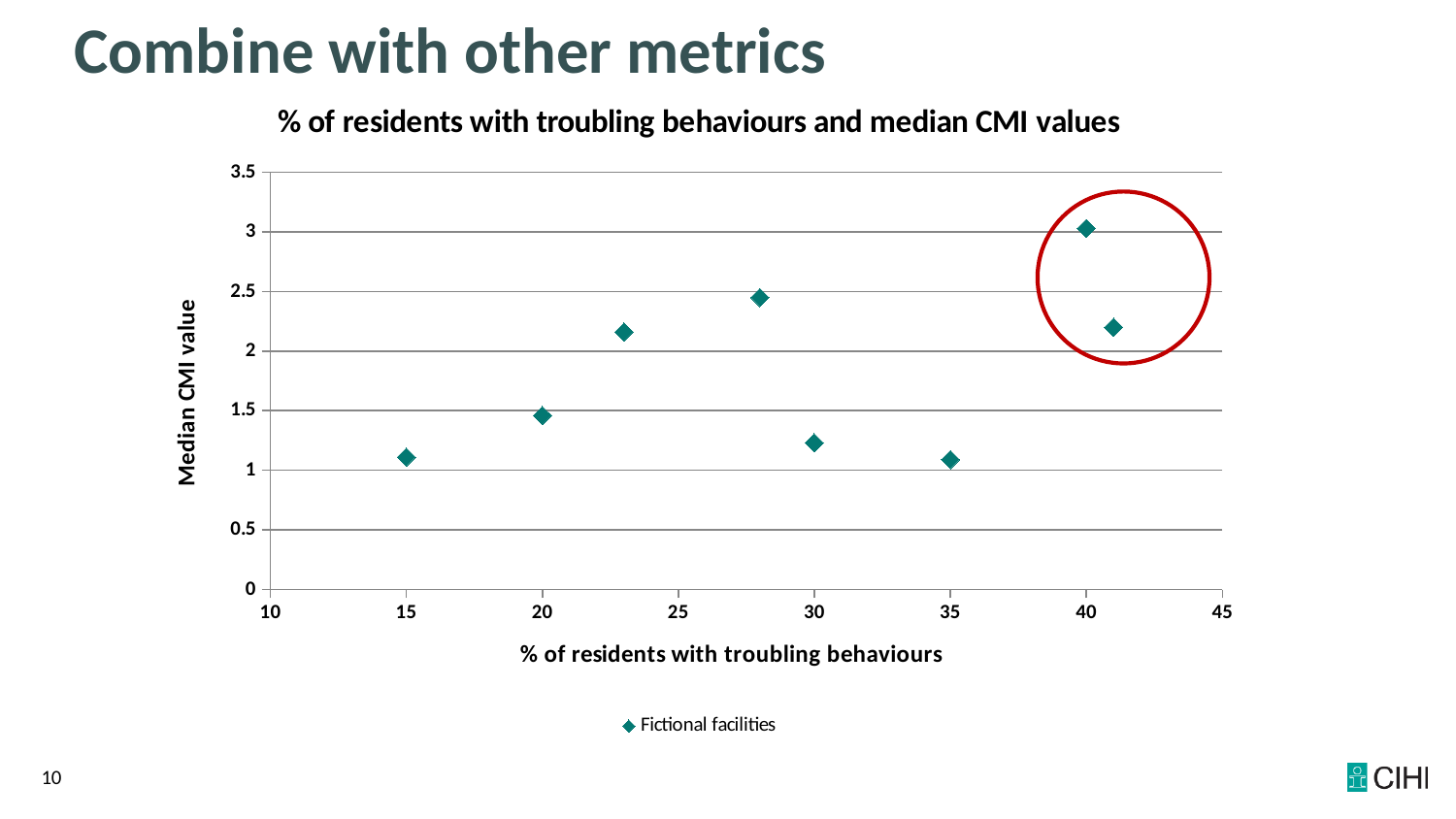
Is the median CMI value for the point at 15% of residents with troubling behaviours greater or less than 1.5? less Is the median CMI value for the point at 35% of residents with troubling behaviours greater or less than 1.5? less Which point has the higher median CMI value: the one at 23% or the one at 28% of residents with troubling behaviours? 28% Is the median CMI value for the point at 28% of residents with troubling behaviours greater or less than 2? greater What is the name of the series shown in the legend? Fictional facilities What is the title of the chart? % of residents with troubling behaviours and median CMI values Which point has the higher median CMI value: the one at 30% or the one at 41% of residents with troubling behaviours? 41% How many data points are plotted on the chart? 8 How many series does the legend list? 1 Which point has the highest median CMI value, by its % of residents with troubling behaviours? 40 What kind of chart is shown on the slide? scatter chart